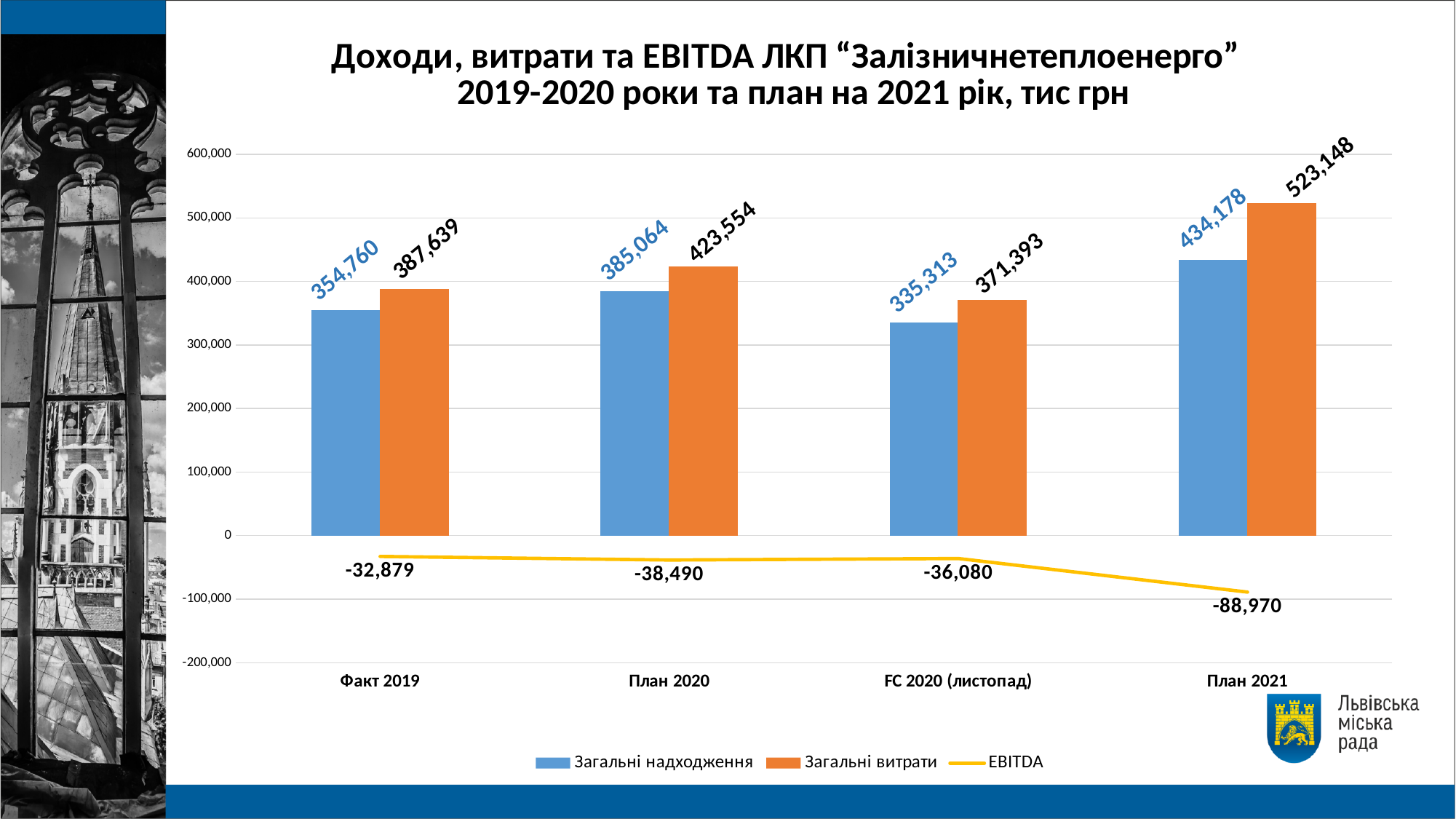
What is the value of Загальні витрати for План 2021? 523,148 What is the value of Загальні надходження for Факт 2019? 354,760 Which is larger for FC 2020 (листопад): Загальні надходження or Загальні витрати? Загальні витрати What is the difference between Загальні витрати and Загальні надходження for План 2021? 88,970 What is the value of Загальні витрати for План 2020? 423,554 How many categories are shown on the x axis? 4 What is the EBITDA value for FC 2020 (листопад)? -36,080 Which category has the lowest EBITDA value? План 2021 Which series is shown as a line rather than bars? EBITDA How many series does the legend list? 3 Is the value of Загальні витрати for План 2021 greater or less than 500,000? greater Which category has the highest value for Загальні надходження? План 2021